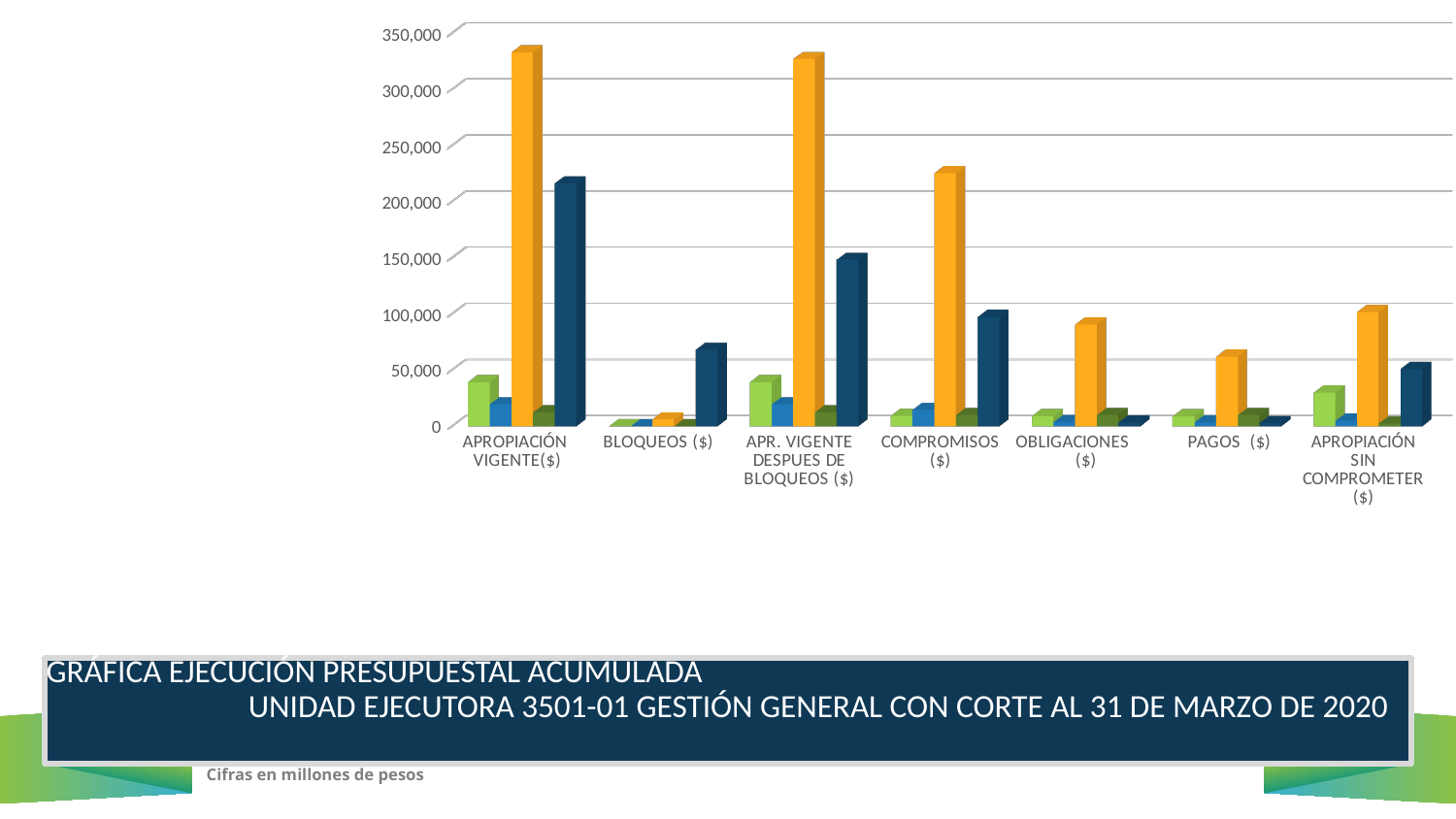
According to the note below the chart, in what units are the figures expressed? Millones de pesos How many categories are shown along the x axis of the chart? 7 Which has the taller orange bar, PAGOS ($) or APROPIACIÓN SIN COMPROMETER ($)? APROPIACIÓN SIN COMPROMETER ($) Is the dark blue bar for BLOQUEOS ($) greater or less than 50,000? greater Which category has the tallest dark blue bar? APROPIACIÓN VIGENTE($) Is the orange bar for OBLIGACIONES ($) greater or less than 100,000? less Is the orange bar for COMPROMISOS ($) greater or less than 200,000? greater Which has the taller orange bar, COMPROMISOS ($) or OBLIGACIONES ($)? COMPROMISOS ($) Which category has the shortest orange bar? BLOQUEOS ($) What is the highest value shown on the vertical axis of the chart? 350,000 What kind of chart is shown on the slide? Bar chart